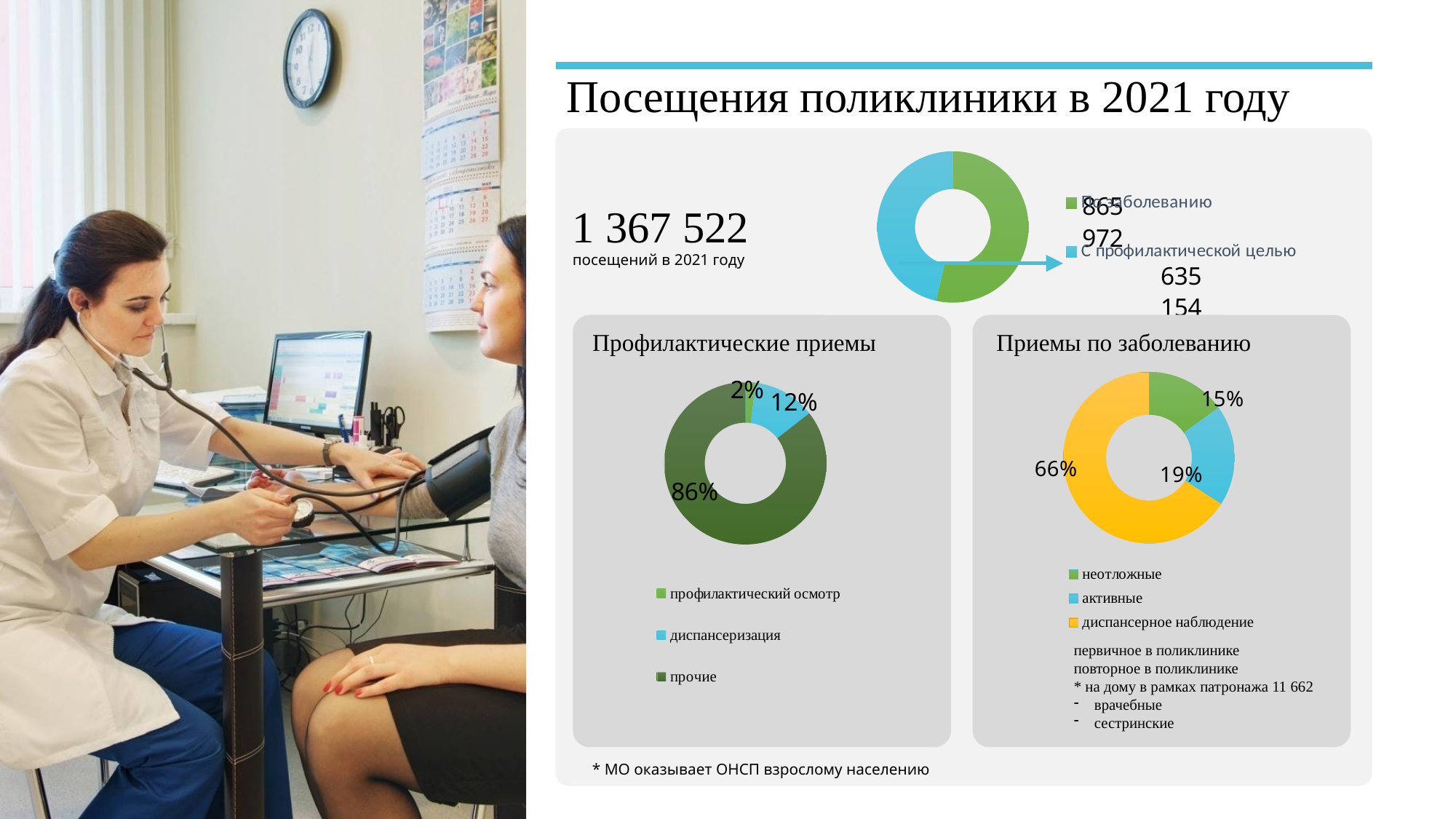
In the 'Профилактические приемы' chart, what share is 'прочие'? 86% In the 'Профилактические приемы' chart, what share is 'профилактический осмотр'? 2% In the 'Приемы по заболеванию' chart, what share is 'диспансерное наблюдение'? 66% In the 'Приемы по заболеванию' chart, what is the difference in percentage points between 'активные' and 'неотложные'? 4 In the 'Приемы по заболеванию' chart, what share is 'неотложные'? 15% In the 'Приемы по заболеванию' chart, which category has the largest share? диспансерное наблюдение In the 'Приемы по заболеванию' chart, what share is 'активные'? 19% In the top chart, what is the value for 'С профилактической целью'? 635 154 In the 'Профилактические приемы' chart, which category has the smallest share? профилактический осмотр What kind of chart is used in the 'Приемы по заболеванию' panel? Doughnut (pie) chart In the 'Профилактические приемы' chart, what share is 'диспансеризация'? 12% In the 'Профилактические приемы' chart, how many categories does the legend list? 3